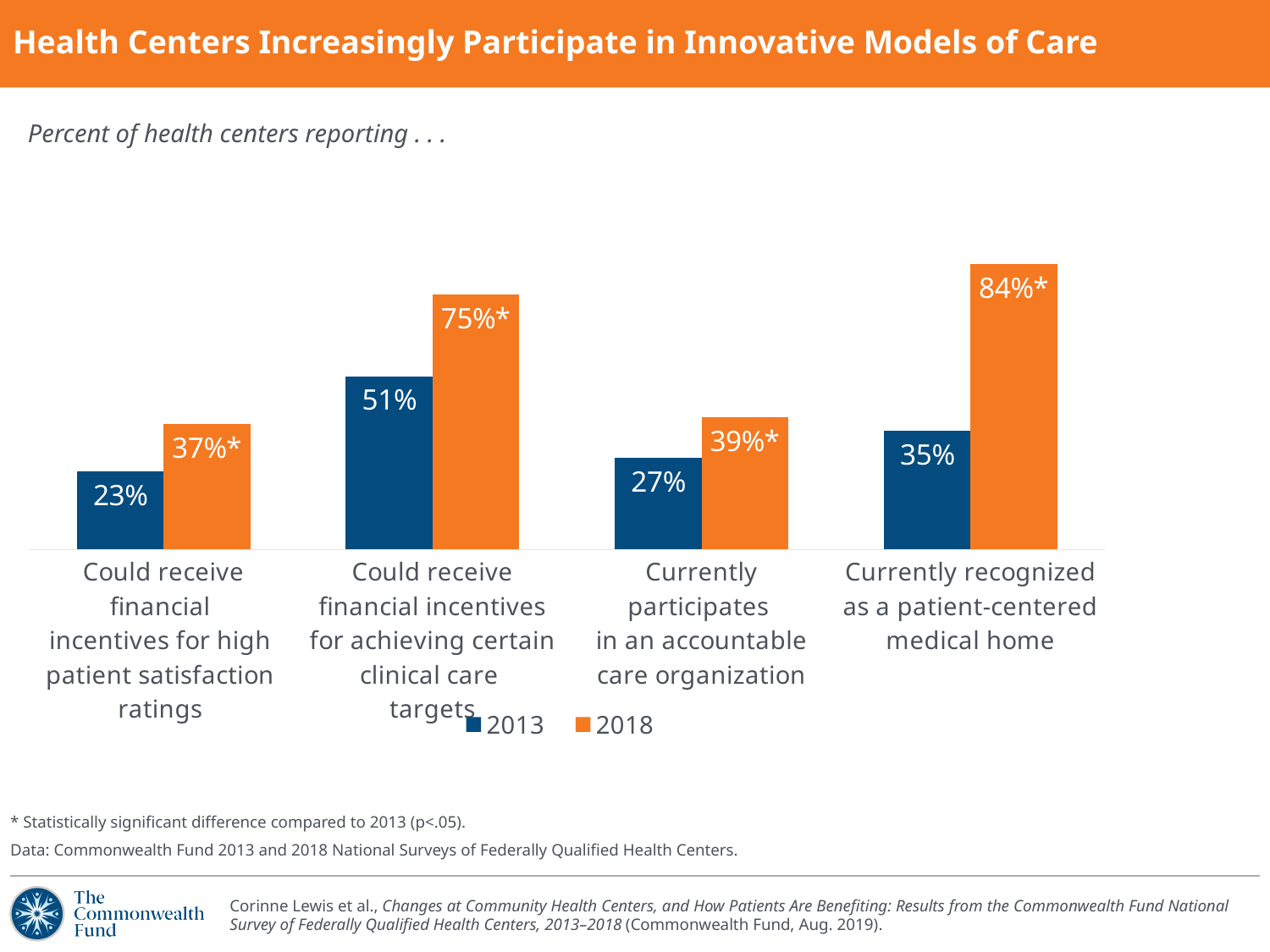
How many categories are shown on the x axis of the chart? 4 What is the 2013 value for health centers currently participating in an accountable care organization? 27% What is the 2018 value for health centers that could receive financial incentives for achieving certain clinical care targets? 75%* What is the difference between the 2018 and 2013 values for health centers that could receive financial incentives for achieving certain clinical care targets? 24 percentage points Which is larger: the 2013 value for participating in an accountable care organization or the 2013 value for being recognized as a patient-centered medical home? Recognized as a patient-centered medical home (35%) What percent of health centers reported in 2013 that they could receive financial incentives for high patient satisfaction ratings? 23% Which category has the highest 2018 value? Currently recognized as a patient-centered medical home How many series does the legend list? 2 What percent of health centers reported in 2018 that they were currently recognized as a patient-centered medical home? 84%* Which category has the lowest 2013 value? Could receive financial incentives for high patient satisfaction ratings What type of chart is shown on the slide? Bar chart By how many percentage points did the share of health centers recognized as a patient-centered medical home increase from 2013 to 2018? 49 percentage points